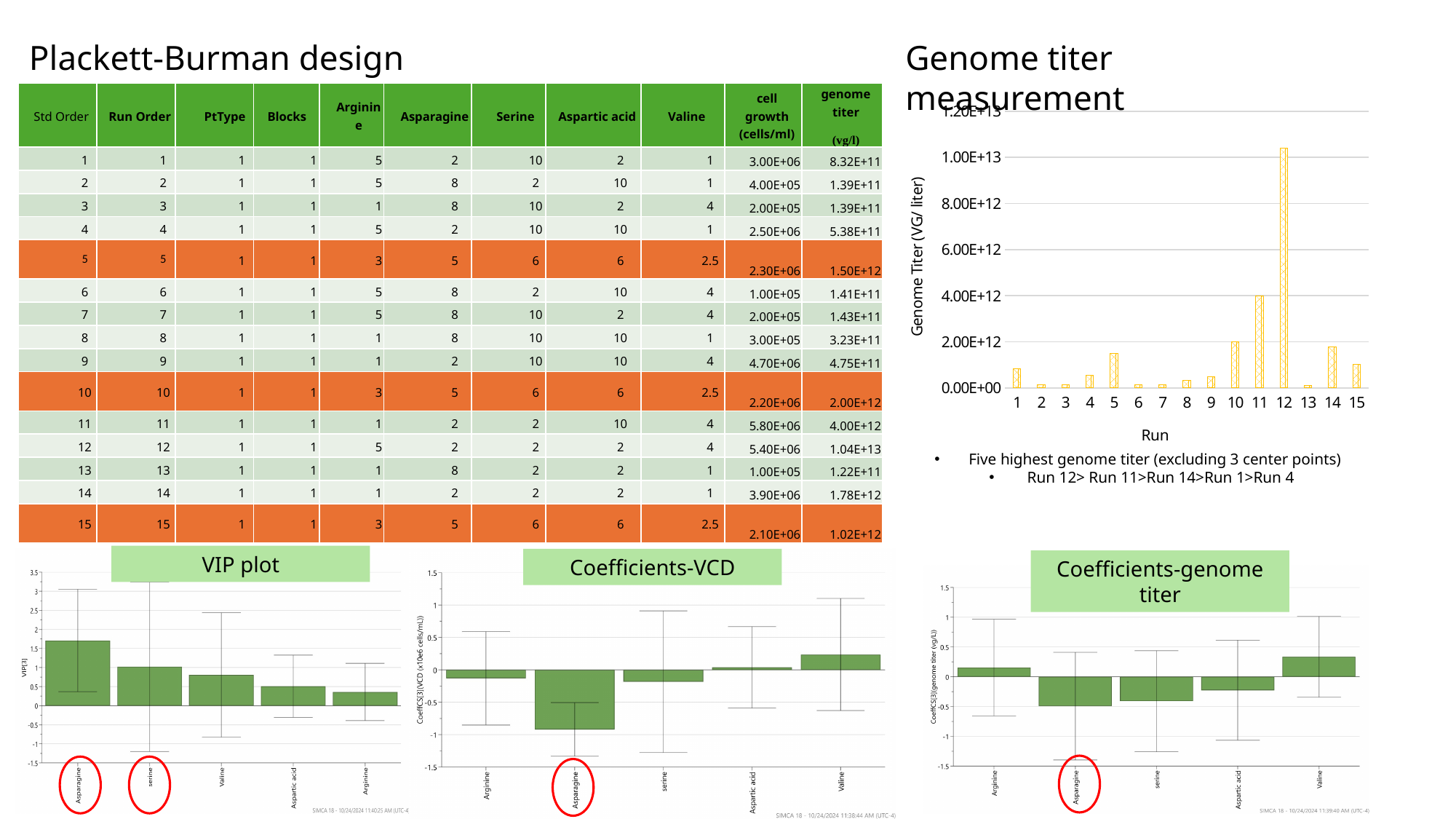
In the Genome titer measurement chart, which is larger, the value for Run 11 or the value for Run 5? Run 11 In the Genome titer measurement chart, what is the label of the y axis? Genome Titer (VG/ liter) In the Genome titer measurement chart, which run has the highest genome titer? Run 12 In the Coefficients-VCD chart, which variable has the lowest coefficient? Asparagine In the VIP plot, which two variables are circled in red? Asparagine and serine In the Genome titer measurement chart, is the value for Run 14 greater or less than 2.00E+12? less In the VIP plot, is the value for Asparagine greater or less than 1.5? greater In the Genome titer measurement chart, how many runs are plotted on the x axis? 15 In the Genome titer measurement chart, what kind of chart is used? bar chart In the VIP plot, which variable has the highest VIP value? Asparagine In the Coefficients-genome titer chart, which variable has the highest coefficient? Valine In the Genome titer measurement chart, is the value for Run 11 greater or less than 2.00E+12? greater